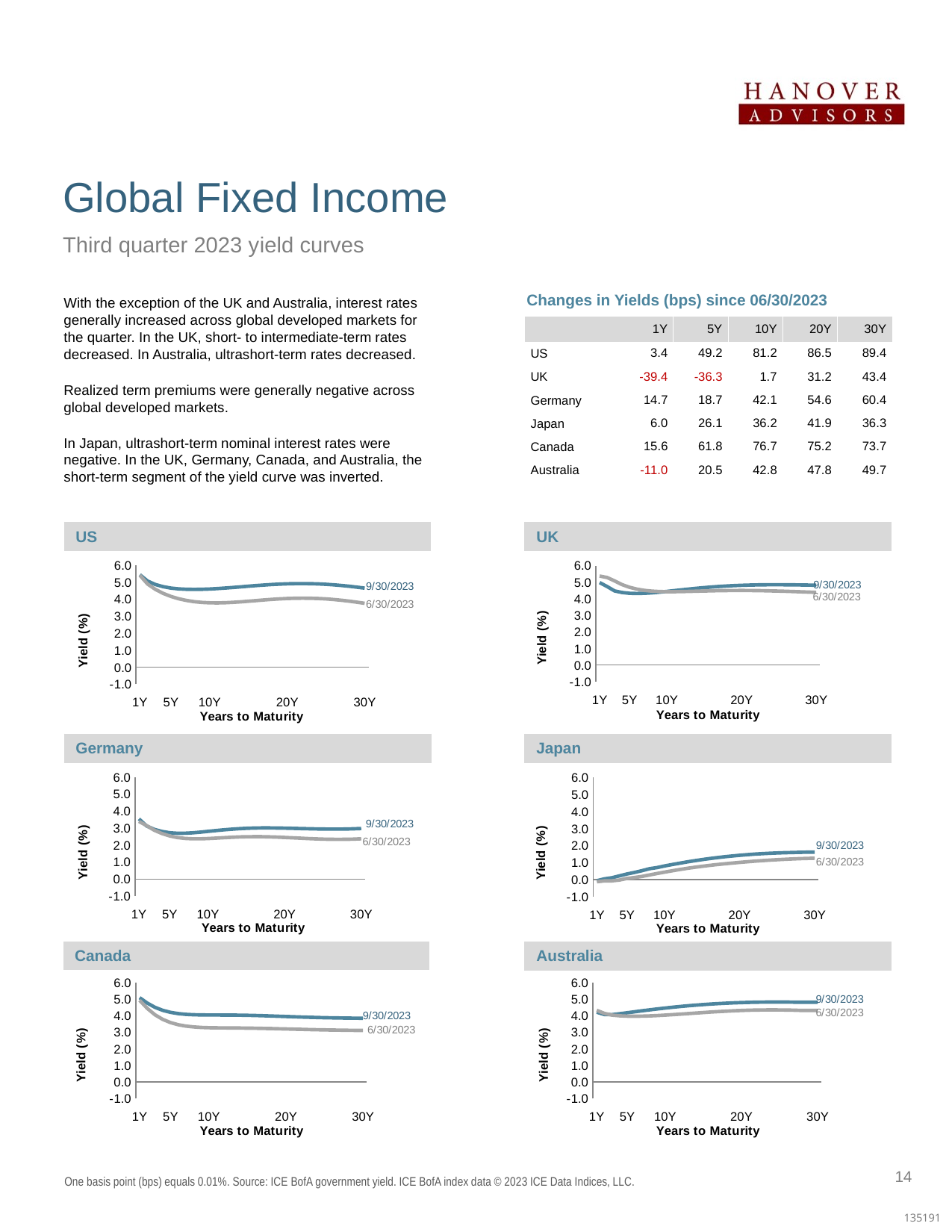
In the Canada chart, is the 9/30/2023 yield at 1Y greater or less than 4.0? greater What kind of chart is the US chart? line chart In the Japan chart, do the 9/30/2023 yields rise or fall as years to maturity increase? rise In the US chart, which series has the higher yield at 10Y, 9/30/2023 or 6/30/2023? 9/30/2023 In the Japan chart, is the 9/30/2023 yield at 1Y greater or less than 1.0? less In the Germany chart, is the 9/30/2023 yield at 30Y greater or less than 2.0? greater In the Canada chart, do the 9/30/2023 yields rise or fall from 1Y to 30Y? fall What is the y-axis title of the Australia chart? Yield (%) What is the x-axis title of the UK chart? Years to Maturity In the Canada chart, how many maturity points are labelled on the x axis? 5